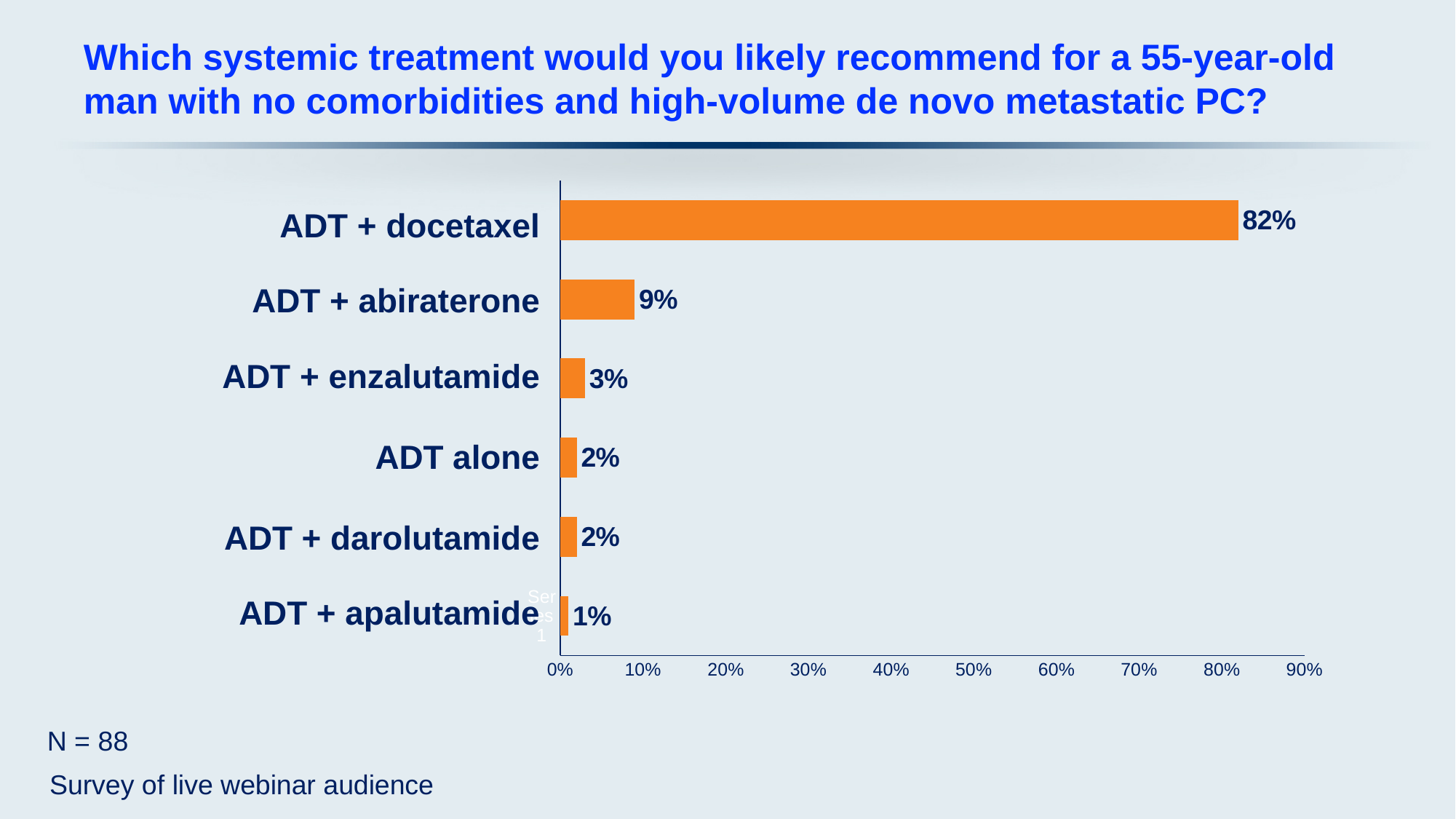
How many treatment options are shown in the chart? 6 Is the value for ADT + docetaxel greater or less than 80%? greater What percentage of respondents chose ADT + apalutamide? 1% What is the sample size (N) stated on the slide? 88 Which treatment option received the highest percentage of responses? ADT + docetaxel What type of chart is shown on the slide? Bar chart What percentage of respondents chose ADT + enzalutamide? 3% What is the difference in percentage points between ADT + docetaxel and ADT + abiraterone? 73 What percentage of respondents chose ADT + docetaxel? 82% Which treatment option received the lowest percentage of responses? ADT + apalutamide Which received a larger share of responses, ADT + abiraterone or ADT + enzalutamide? ADT + abiraterone What percentage of respondents chose ADT + abiraterone? 9%